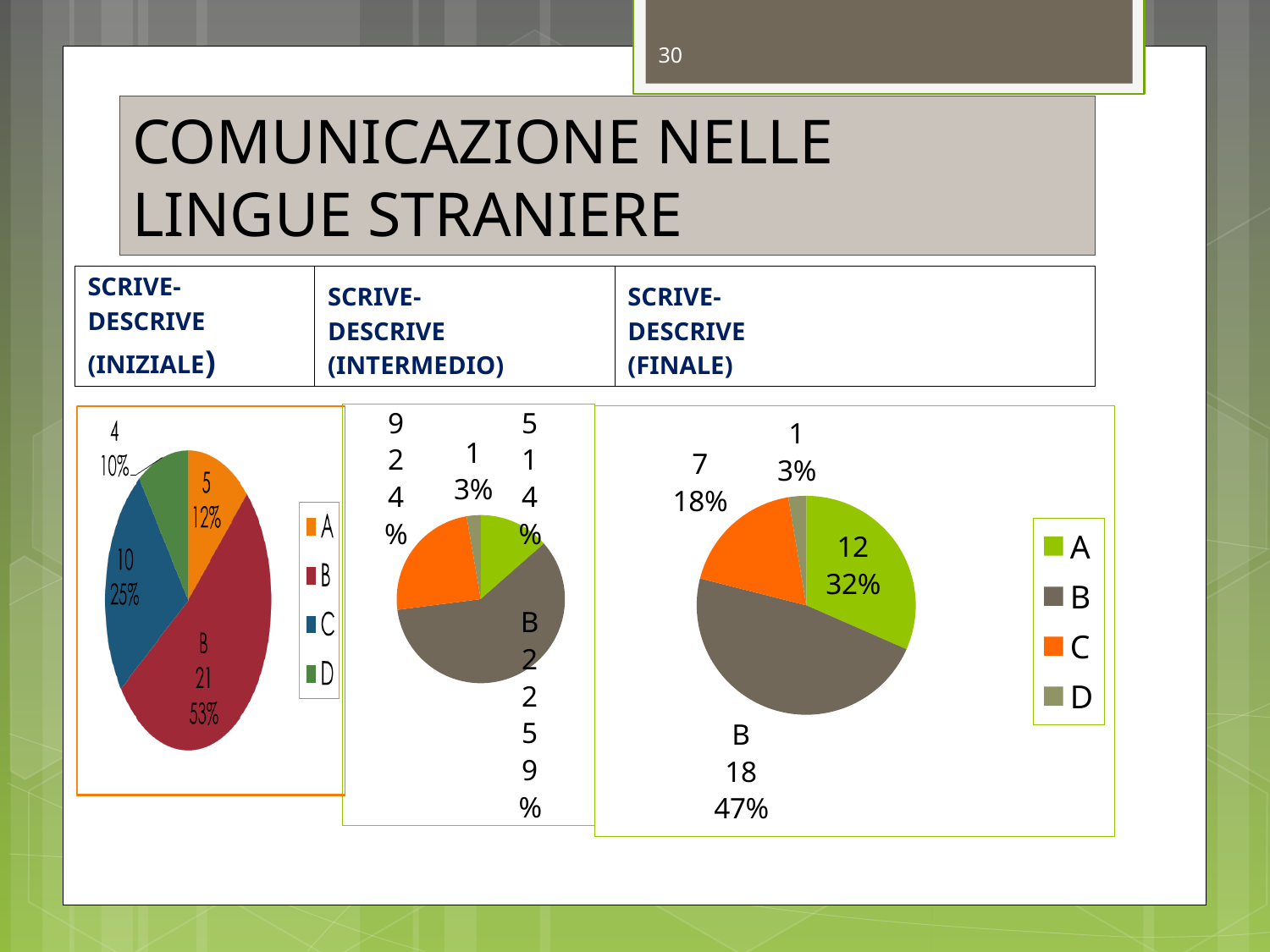
How many entries does the legend of the SCRIVE-DESCRIVE (FINALE) pie chart on the right list? 4 In the SCRIVE-DESCRIVE (FINALE) pie chart on the right, which is larger, slice A or slice C? A In the SCRIVE-DESCRIVE (INIZIALE) pie chart on the left, which slice is the smallest? D In the SCRIVE-DESCRIVE (INIZIALE) pie chart on the left, what percentage is shown for slice B? 53% In the SCRIVE-DESCRIVE (FINALE) pie chart on the right, what percentage is shown for slice A? 32% In the SCRIVE-DESCRIVE (INIZIALE) pie chart on the left, what count is shown for slice C? 10 In the SCRIVE-DESCRIVE (INIZIALE) pie chart on the left, what share of the pie does slice A have? 12% In the SCRIVE-DESCRIVE (FINALE) pie chart on the right, what count is shown for slice B? 18 In the SCRIVE-DESCRIVE (FINALE) pie chart on the right, which slice is the smallest? D In the SCRIVE-DESCRIVE (INTERMEDIO) pie chart in the middle, which slice is the largest? B In the SCRIVE-DESCRIVE (FINALE) pie chart on the right, what is the difference between the counts for B and C? 11 In the SCRIVE-DESCRIVE (INIZIALE) pie chart on the left, what is the difference between the counts for B and A? 16